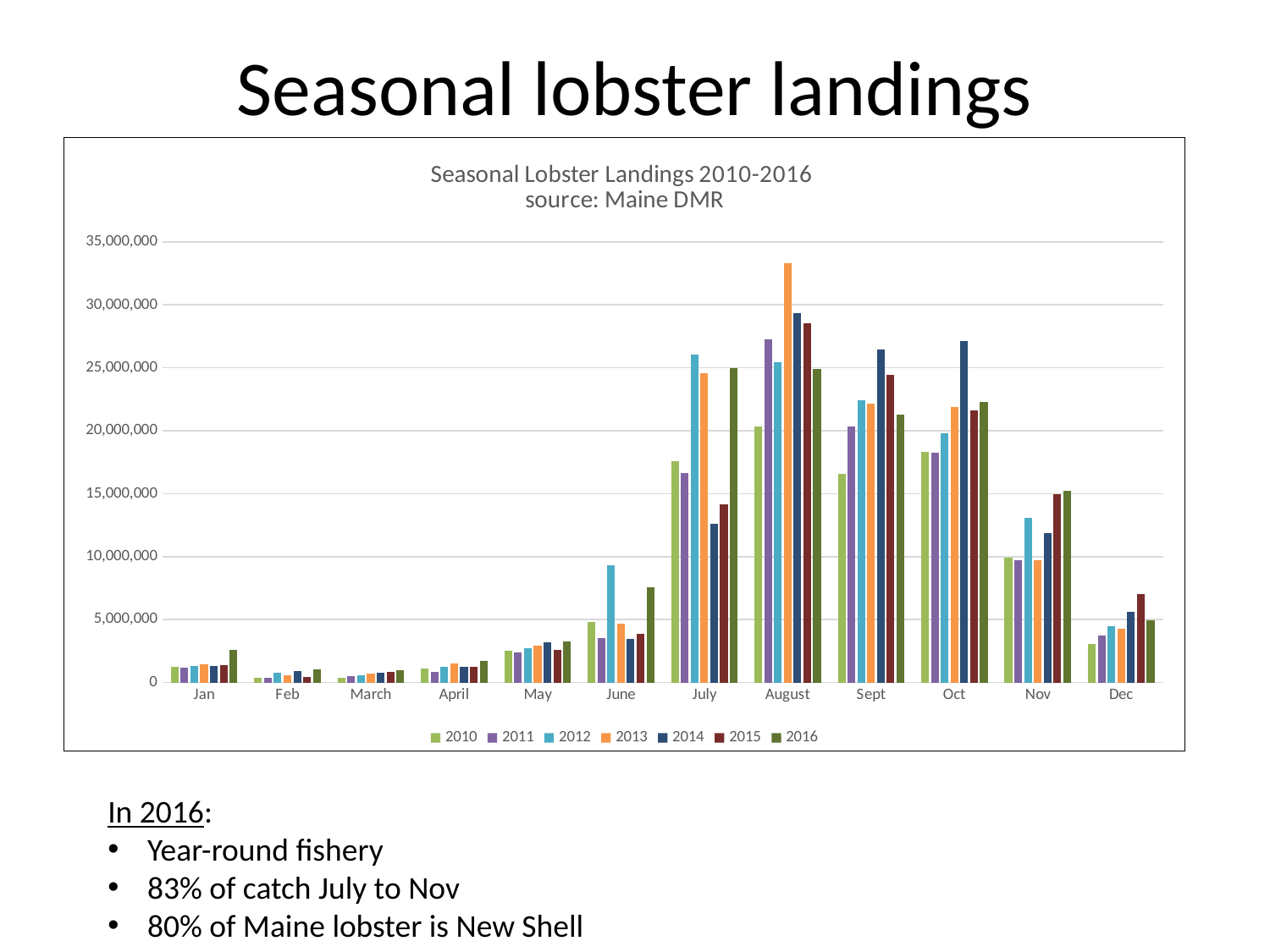
What kind of chart is shown on the slide? bar chart How many series does the chart legend list? 7 Which year has the highest bar in October? 2014 Which year has the highest bar in June? 2012 What is the title of the chart? Seasonal Lobster Landings 2010-2016 source: Maine DMR Which year has the highest bar in August? 2013 For the 2013 series, do the values rise or fall from May to August? rise Is the value for 2013 in August greater or less than 30,000,000? greater Is the value for 2012 in November greater or less than 10,000,000? greater How many months are shown along the x axis of the chart? 12 In July, which is larger: the value for 2012 or the value for 2014? 2012 Is the value for 2014 in July greater or less than 15,000,000? less